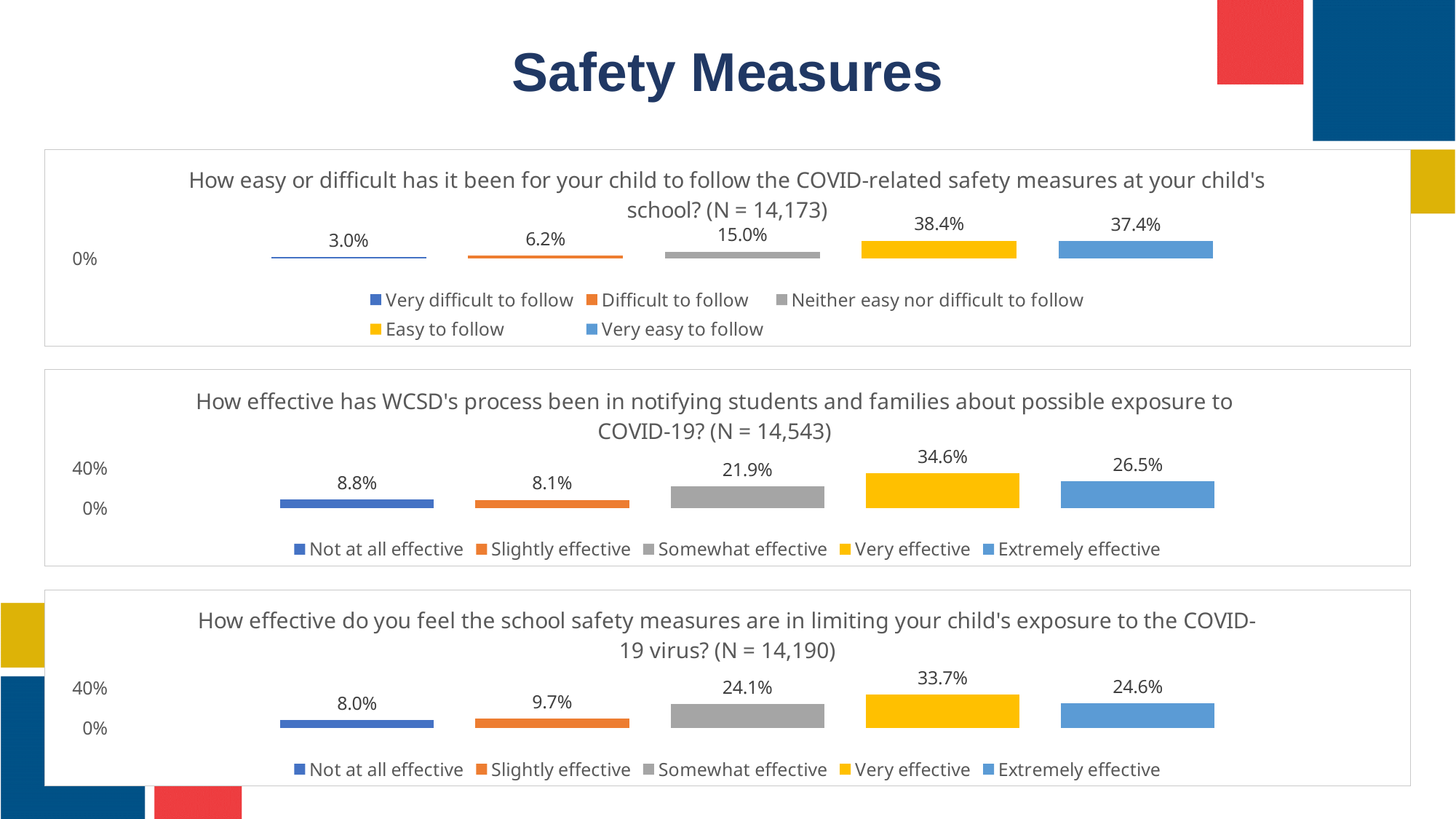
In the bottom chart (school safety measures limiting exposure), what is the difference between 'Very effective' and 'Somewhat effective'? 9.6% In the bottom chart (school safety measures limiting exposure), what percentage of respondents chose 'Extremely effective'? 24.6% In the middle chart (WCSD's notification process), which response has the highest percentage? Very effective In the top chart (how easy or difficult to follow safety measures), how many response categories are plotted? 5 In the top chart (how easy or difficult to follow safety measures), what is the difference between 'Easy to follow' and 'Very easy to follow'? 1.0% In the bottom chart (school safety measures limiting exposure), is the value for 'Very effective' greater or less than 40%? less In the middle chart (WCSD's notification process), which is larger: 'Not at all effective' or 'Slightly effective'? Not at all effective What type of chart is used in the middle chart (WCSD's notification process)? Bar chart In the top chart (how easy or difficult to follow safety measures), which response has the lowest percentage? Very difficult to follow How many series does the legend of the bottom chart (school safety measures limiting exposure) list? 5 In the top chart (how easy or difficult to follow safety measures), what percentage of respondents chose 'Easy to follow'? 38.4% In the middle chart (WCSD's notification process), what percentage of respondents chose 'Somewhat effective'? 21.9%